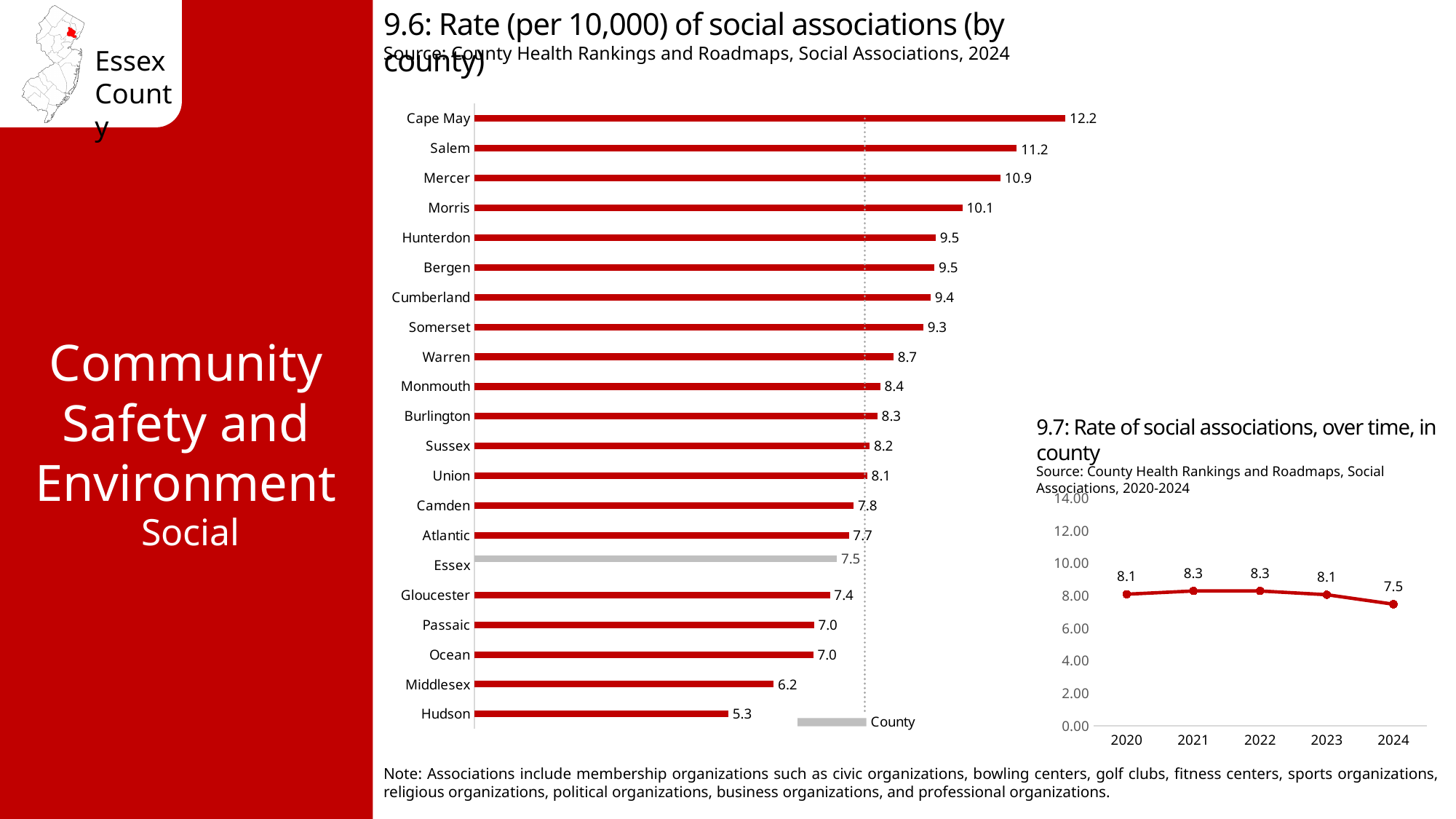
In the chart 9.6 (rate of social associations by county), which is larger, the value for Mercer or the value for Morris? Mercer In the chart 9.7 (rate of social associations over time), what is the value for 2024? 7.5 In the chart 9.7 (rate of social associations over time), what is the difference between the 2022 value and the 2024 value? 0.8 In the chart 9.6 (rate of social associations by county), what is the difference between Cape May and Hudson? 6.9 What kind of chart is chart 9.6 (rate of social associations by county)? Bar chart In the chart 9.6 (rate of social associations by county), which county has the highest rate? Cape May What kind of chart is chart 9.7 (rate of social associations over time)? Line chart In the chart 9.6 (rate of social associations by county), what is the value for Middlesex? 6.2 In the chart 9.6 (rate of social associations by county), which county has the lowest rate? Hudson In the chart 9.6 (rate of social associations by county), how many counties are plotted? 21 In the chart 9.6 (rate of social associations by county), what is the value for Essex? 7.5 In the chart 9.7 (rate of social associations over time), which year has the lowest value? 2024